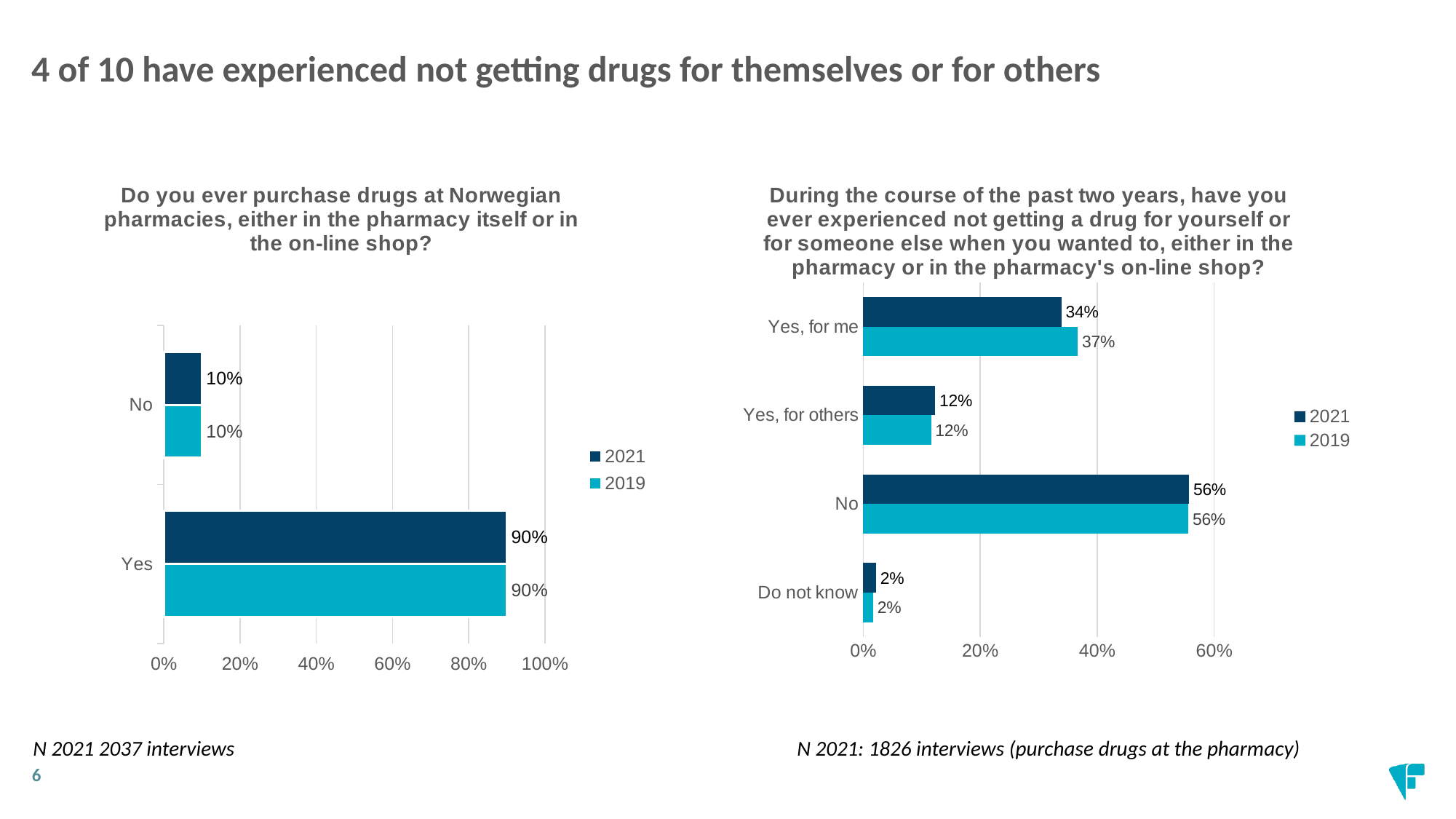
In the right chart (During the course of the past two years...), what is the 2021 value for 'Yes, for me'? 34% In the right chart (During the course of the past two years...), which is larger: the 2021 value for 'Yes, for me' or the 2021 value for 'Yes, for others'? Yes, for me In the left chart (Do you ever purchase drugs at Norwegian pharmacies...), what is the 2021 value for Yes? 90% In the right chart (During the course of the past two years...), what is the difference between the 2019 and 2021 values for 'Yes, for me'? 3% In the right chart (During the course of the past two years...), which category has the highest 2021 value? No How many categories are shown in the right chart (During the course of the past two years...)? 4 In the left chart (Do you ever purchase drugs at Norwegian pharmacies...), what is the difference between the 2021 values for Yes and No? 80% In the right chart (During the course of the past two years...), which category has the lowest 2019 value? Do not know In the right chart (During the course of the past two years...), what is the 2019 value for 'Yes, for me'? 37% In the left chart (Do you ever purchase drugs at Norwegian pharmacies...), what is the 2019 value for No? 10% In the right chart (During the course of the past two years...), what is the 2021 value for 'Do not know'? 2% How many series does the legend of the left chart (Do you ever purchase drugs at Norwegian pharmacies...) list? 2